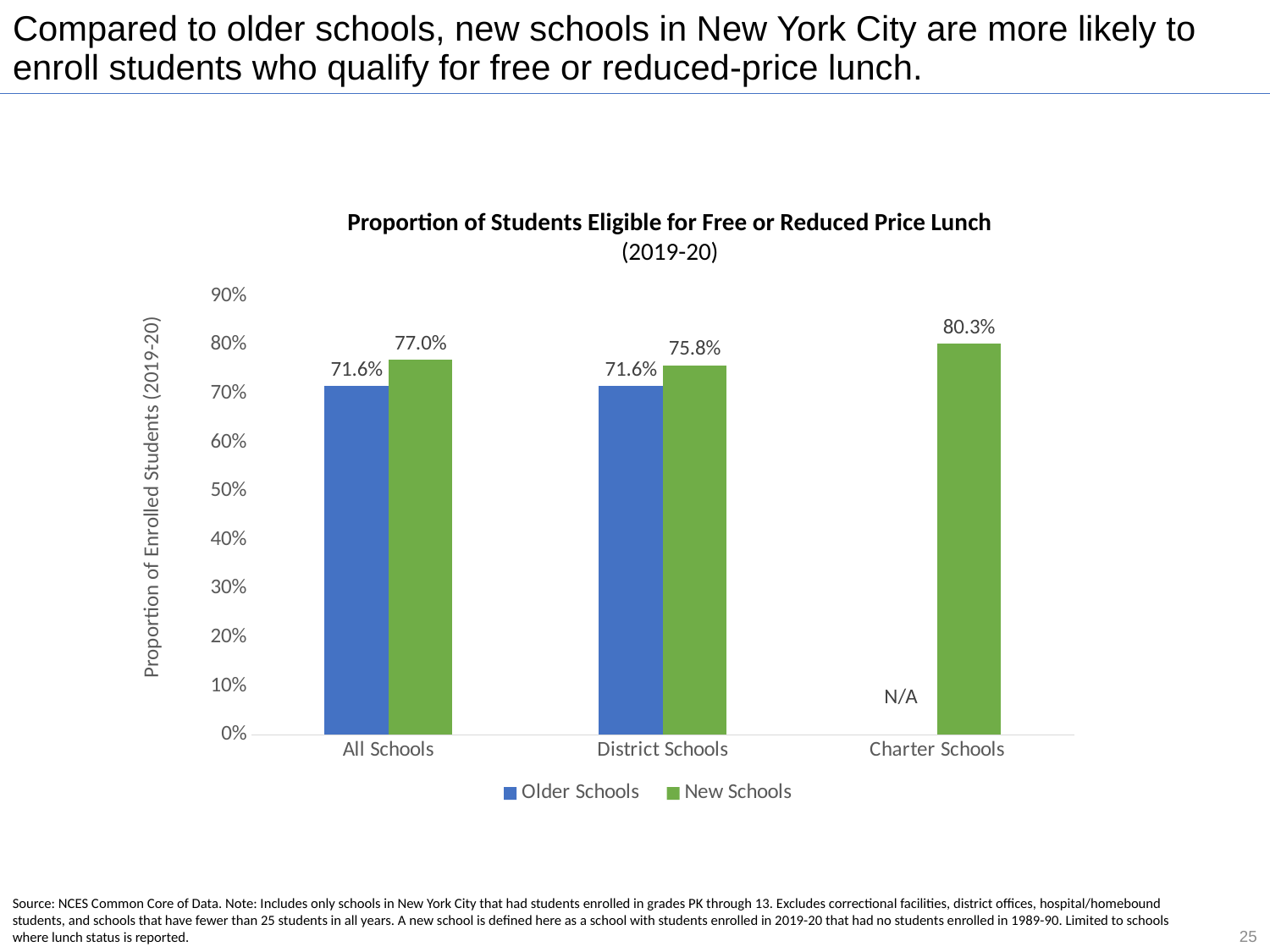
How many series does the legend list? 2 Which category has the highest value for New Schools? Charter Schools In the District Schools category, which is larger: Older Schools or New Schools? New Schools How many categories are shown on the x axis? 3 What is the value for Older Schools in the District Schools category? 71.6% What is the difference between New Schools and Older Schools in the All Schools category? 5.4% Is the value for New Schools in the Charter Schools category greater or less than 80%? greater What is the value for New Schools in the Charter Schools category? 80.3% What is the value for New Schools in the All Schools category? 77.0% Which category has the lowest value for New Schools? District Schools What is shown for Older Schools in the Charter Schools category? N/A What kind of chart is this? Bar chart